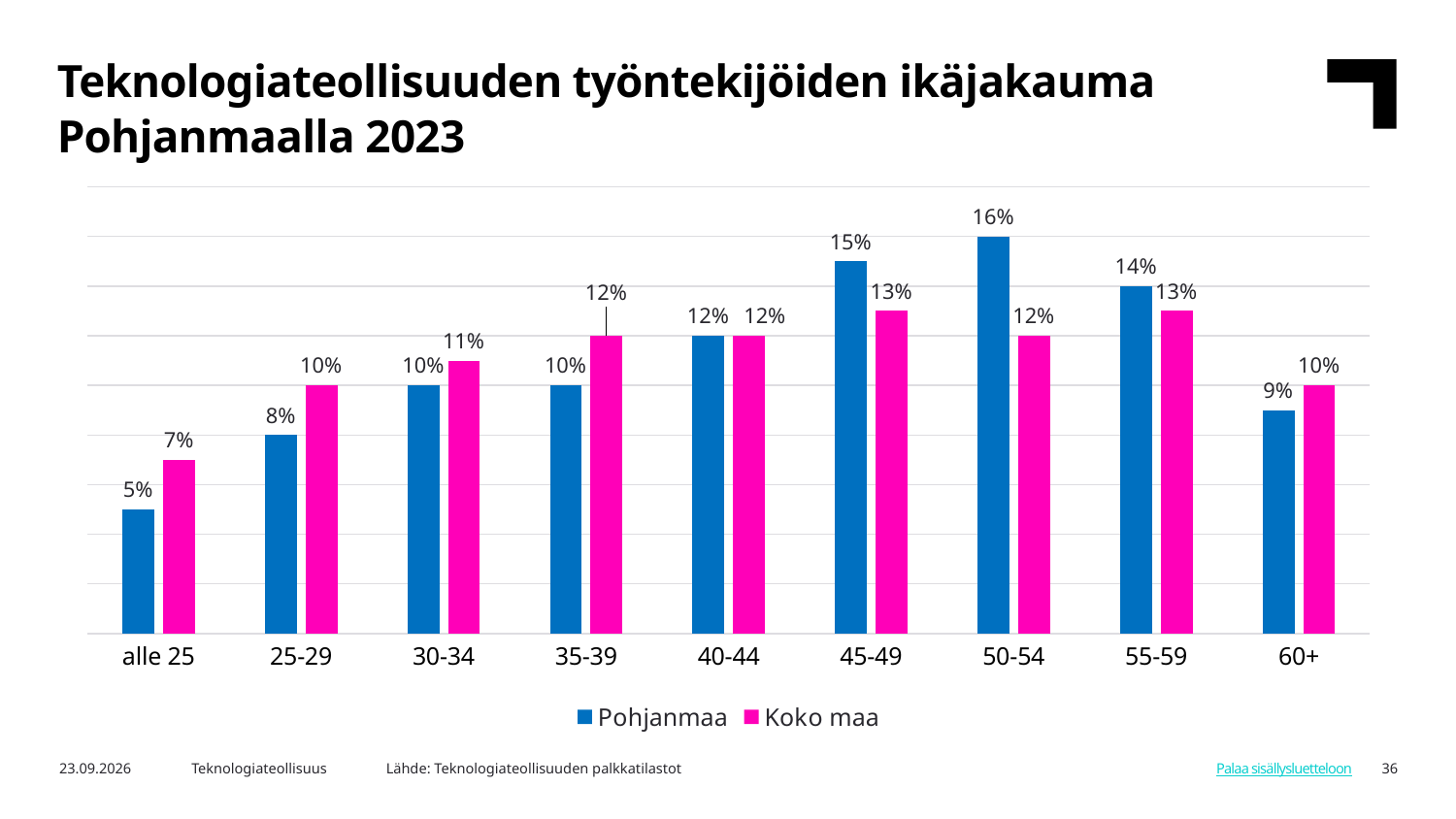
What is the Pohjanmaa value for the 50-54 age group? 16% What is the difference between the Pohjanmaa values for the 50-54 and alle 25 age groups? 11% Which age group has the lowest Koko maa value? alle 25 Which series is shown in pink in the legend? Koko maa For the 60+ age group, which is larger: the Pohjanmaa value or the Koko maa value? Koko maa How many series does the legend list? 2 What is the Pohjanmaa value for the alle 25 age group? 5% What kind of chart is shown on the slide? Bar chart How many age groups are shown on the x axis? 9 What is the difference between the Pohjanmaa and Koko maa values for the 45-49 age group? 2% Which age group has the highest Pohjanmaa value? 50-54 What is the Koko maa value for the 35-39 age group? 12%